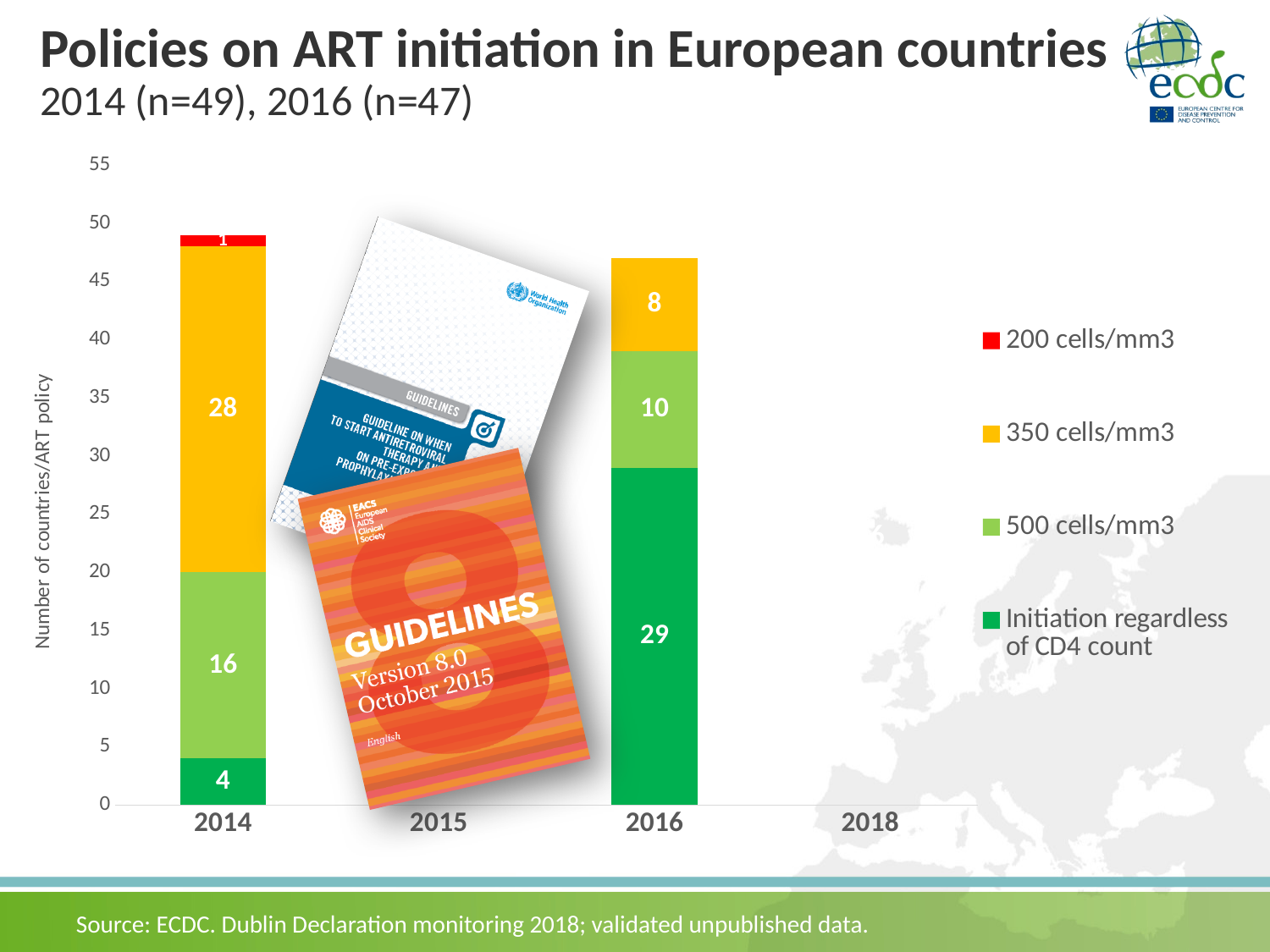
What is the value for '350 cells/mm3' in 2014? 28 What is the value for '200 cells/mm3' in 2014? 1 What is the value for '500 cells/mm3' in 2016? 10 What is the label of the y axis? Number of countries/ART policy Which is larger: the '350 cells/mm3' value in 2014 or in 2016? 2014 What type of chart is shown on the slide? stacked bar chart What is the value for 'Initiation regardless of CD4 count' in 2014? 4 What is the total of the stacked bar for 2014? 49 What is the total of the stacked bar for 2016? 47 What is the difference between the 'Initiation regardless of CD4 count' values in 2016 and 2014? 25 What is the value for 'Initiation regardless of CD4 count' in 2016? 29 How many series does the legend list? 4